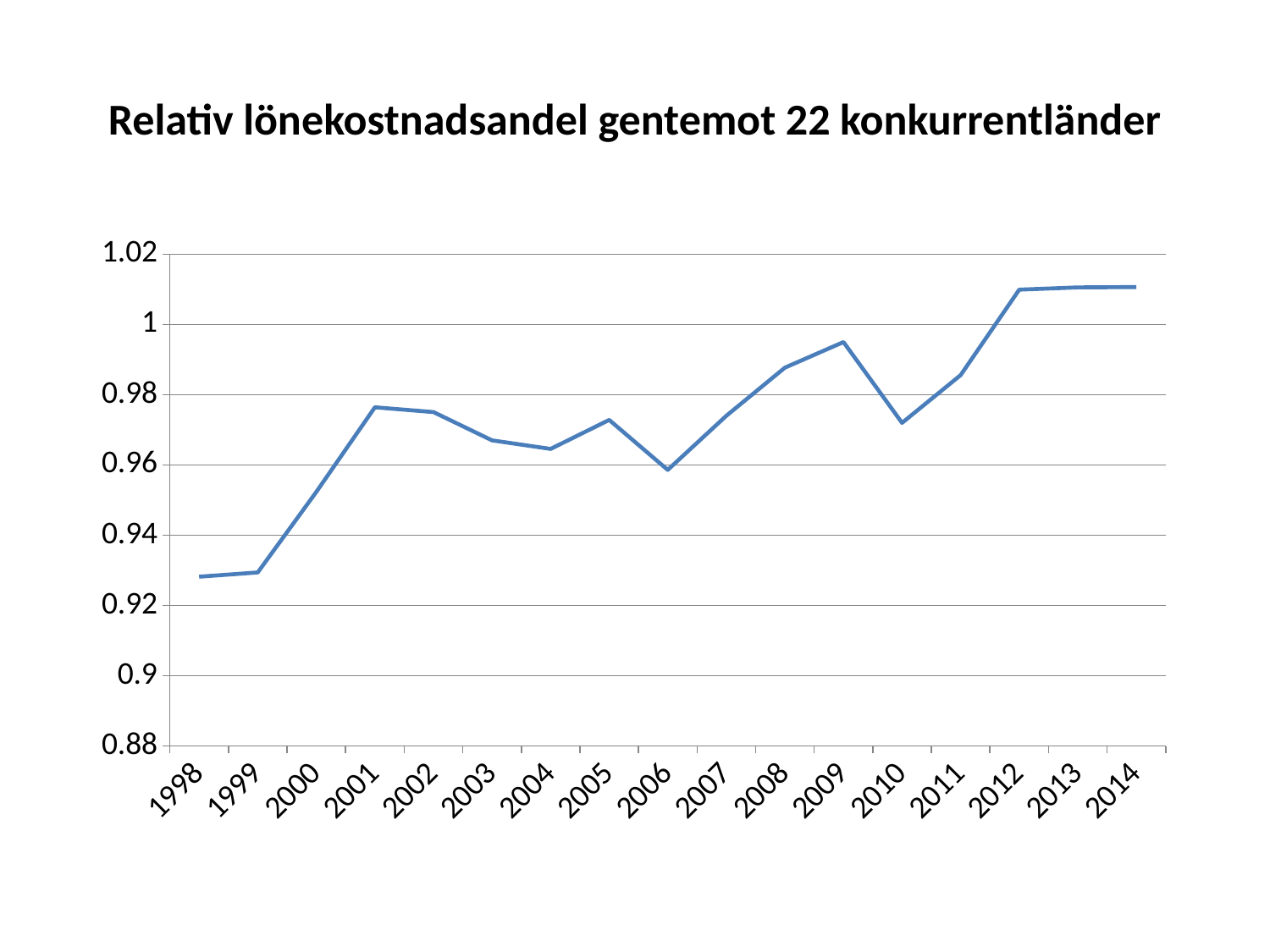
What is the title of the chart? Relativ lönekostnadsandel gentemot 22 konkurrentländer Is the value for 2001 greater or less than 0.96? greater Which year has the larger value, 2001 or 2006? 2001 Is the value for 2009 greater or less than 1? less How many years are plotted along the x axis? 17 Which year has the larger value, 2010 or 2012? 2012 Does the value rise or fall between 1999 and 2001? rise Is the value for 2012 greater or less than 1? greater What kind of chart is shown on the slide? line chart